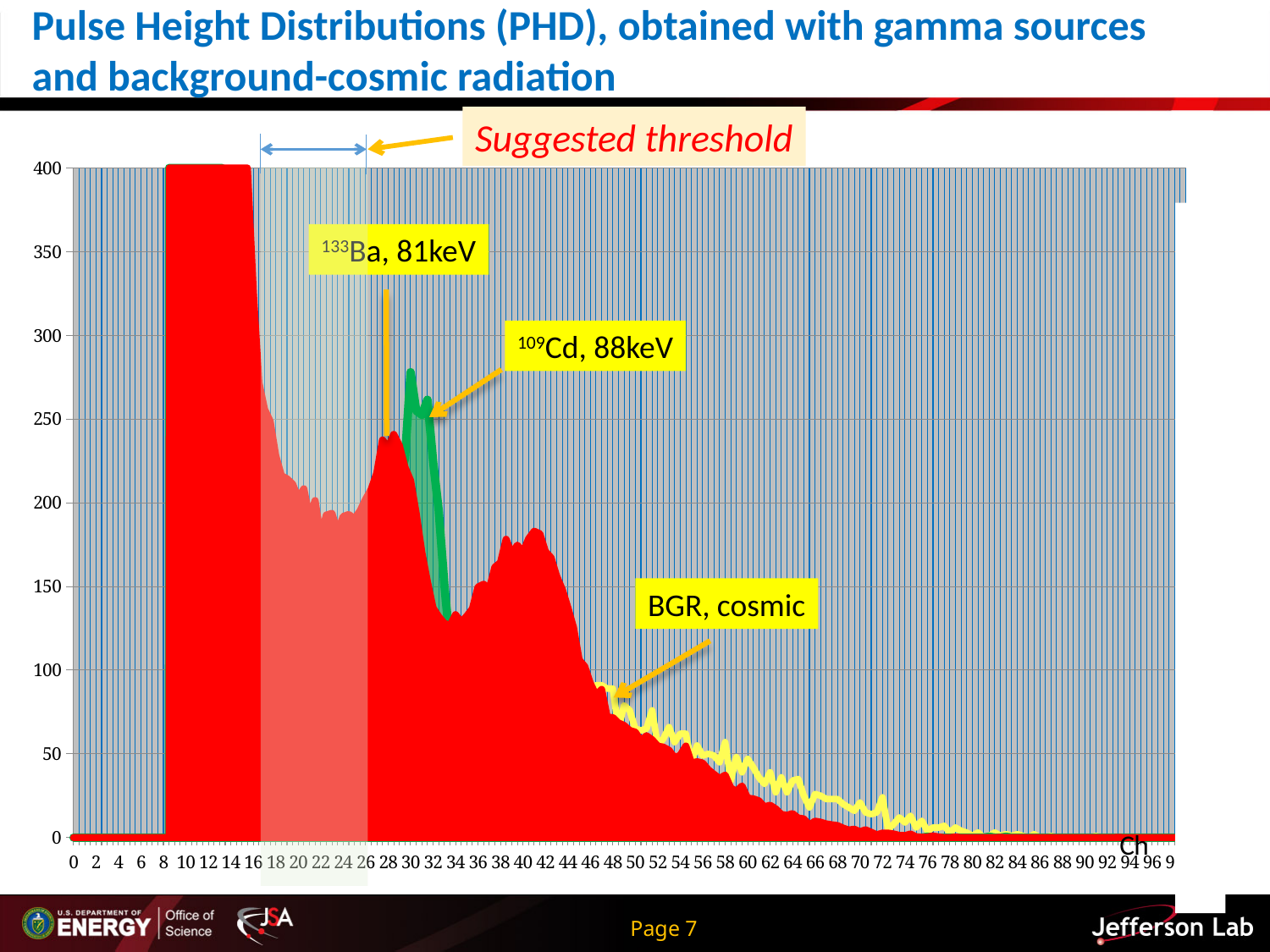
Which gamma source is annotated with an energy of 81keV? 133Ba Do the values of the red distribution rise or fall as the channel increases from 42 to 90? fall What label is shown on the x axis of the chart? Ch Is the value of the red distribution at channel 28 greater or less than 200? greater Is the value of the red distribution at channel 12 greater or less than 350? greater Which is larger: the red distribution value at channel 28 or at channel 60? channel 28 Is the value of the red distribution at channel 40 greater or less than 200? less What is the highest value shown on the y axis of the chart? 400